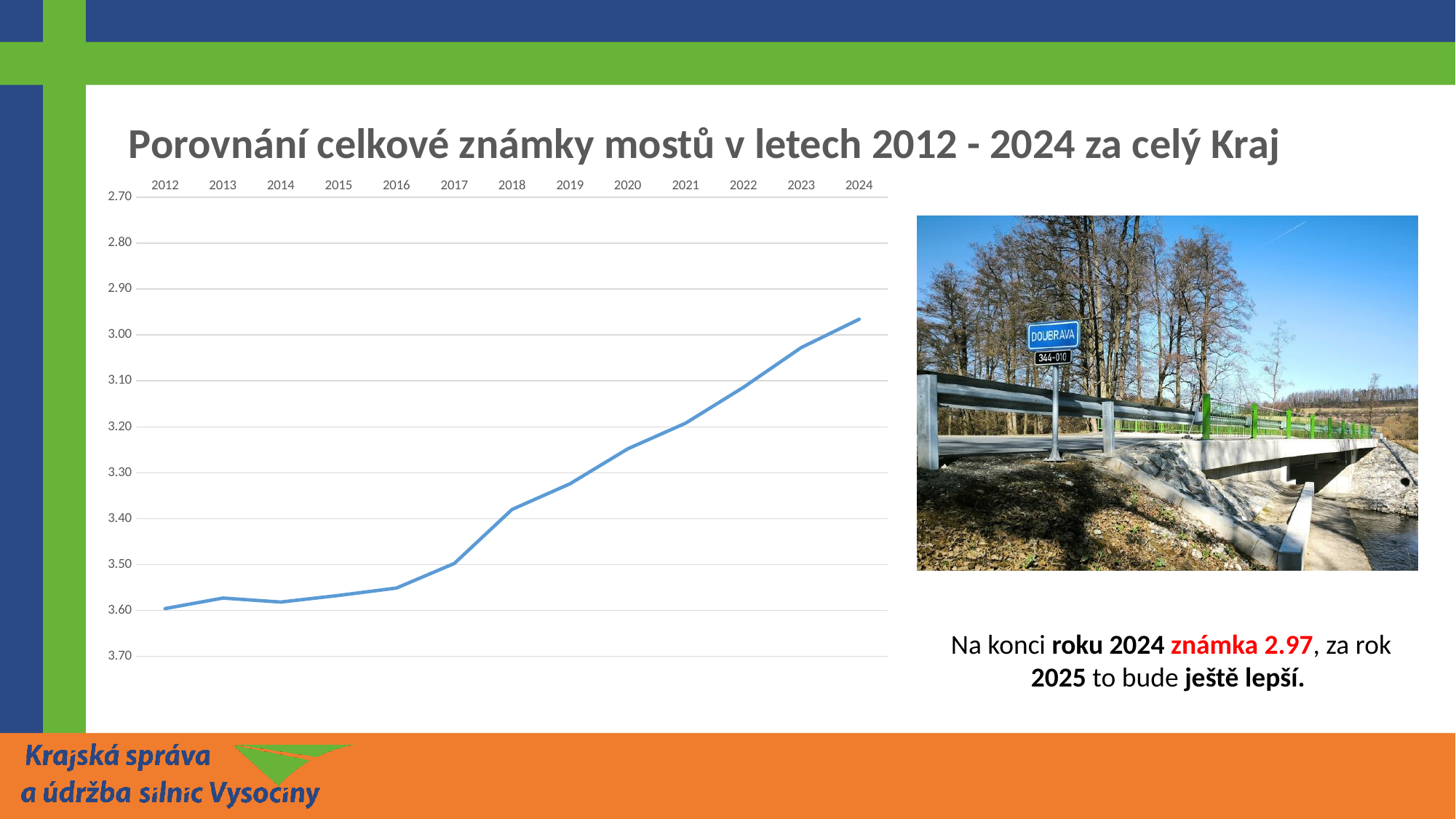
Which year has the numerically larger value, 2012 or 2024? 2012 Is the value for 2018 greater or less than 3.40? less What kind of chart is shown on the slide? line chart Is the value for 2012 greater or less than 3.50? greater Do the plotted values numerically increase or decrease from 2012 to 2024? decrease Is the value for 2016 greater or less than 3.50? greater Which year has the numerically larger value, 2018 or 2020? 2018 How many years are plotted on the x axis of the chart? 13 Which year has the lowest plotted value (numerically) on the chart? 2024 What is the title of the chart? Porovnání celkové známky mostů v letech 2012 - 2024 za celý Kraj